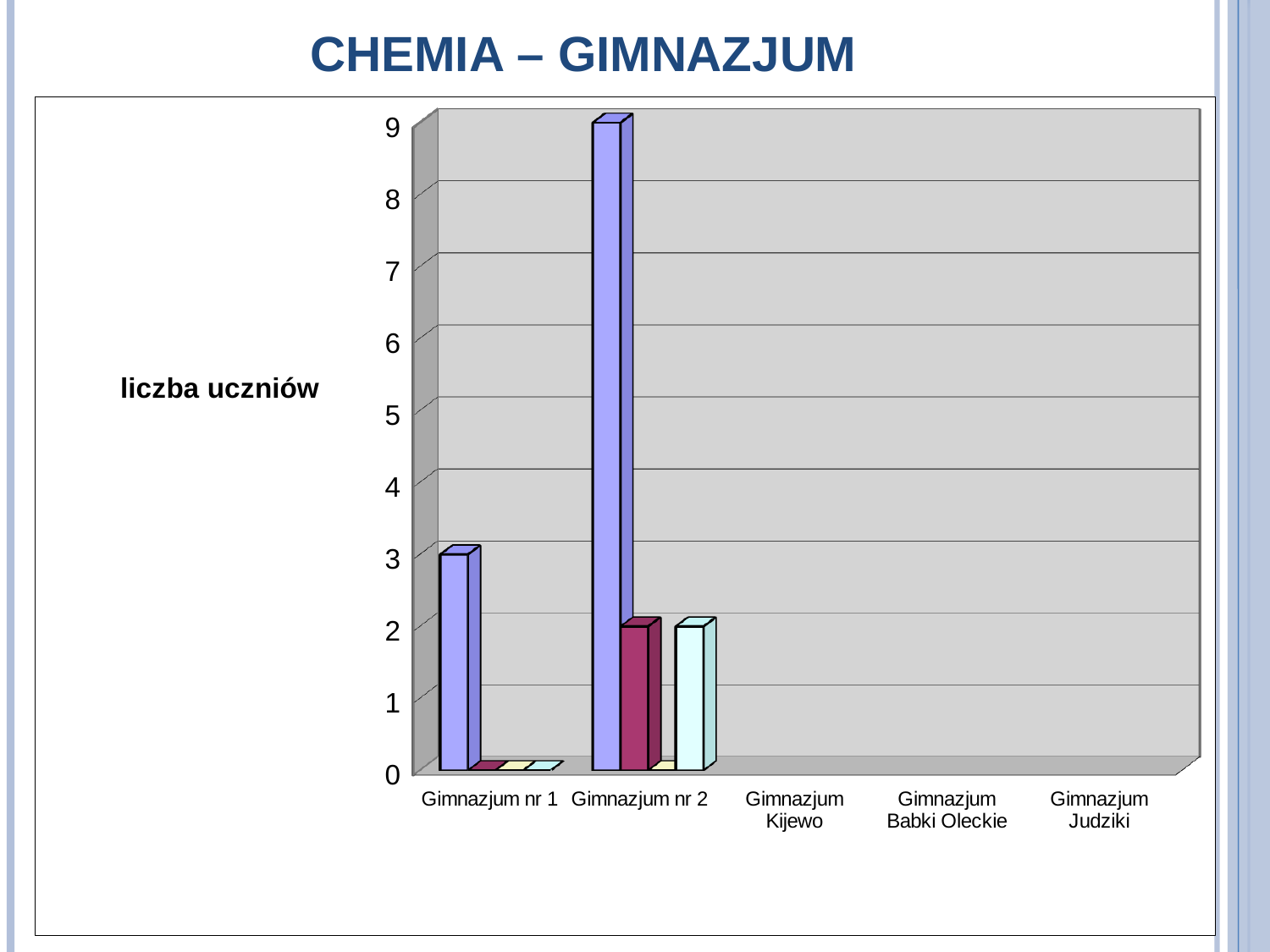
What type of chart is shown on the slide? bar chart What is the value of the tallest bar for Gimnazjum nr 2? 9 What is the label of the vertical axis of the chart? liczba uczniów How many categories are shown on the x axis of the chart? 5 Which is larger: the purple bar for Gimnazjum nr 1 or the purple bar for Gimnazjum nr 2? Gimnazjum nr 2 Which category has the tallest bar in the chart? Gimnazjum nr 2 What is the title of the slide containing the chart? CHEMIA – GIMNAZJUM What is the value of the dark red bar for Gimnazjum nr 2? 2 What is the highest value shown on the vertical axis of the chart? 9 What is the value of the purple bar for Gimnazjum nr 1? 3 Is the value of the tallest bar for Gimnazjum nr 2 greater or less than 5? greater What is the difference between the tallest bar for Gimnazjum nr 2 and the tallest bar for Gimnazjum nr 1? 6